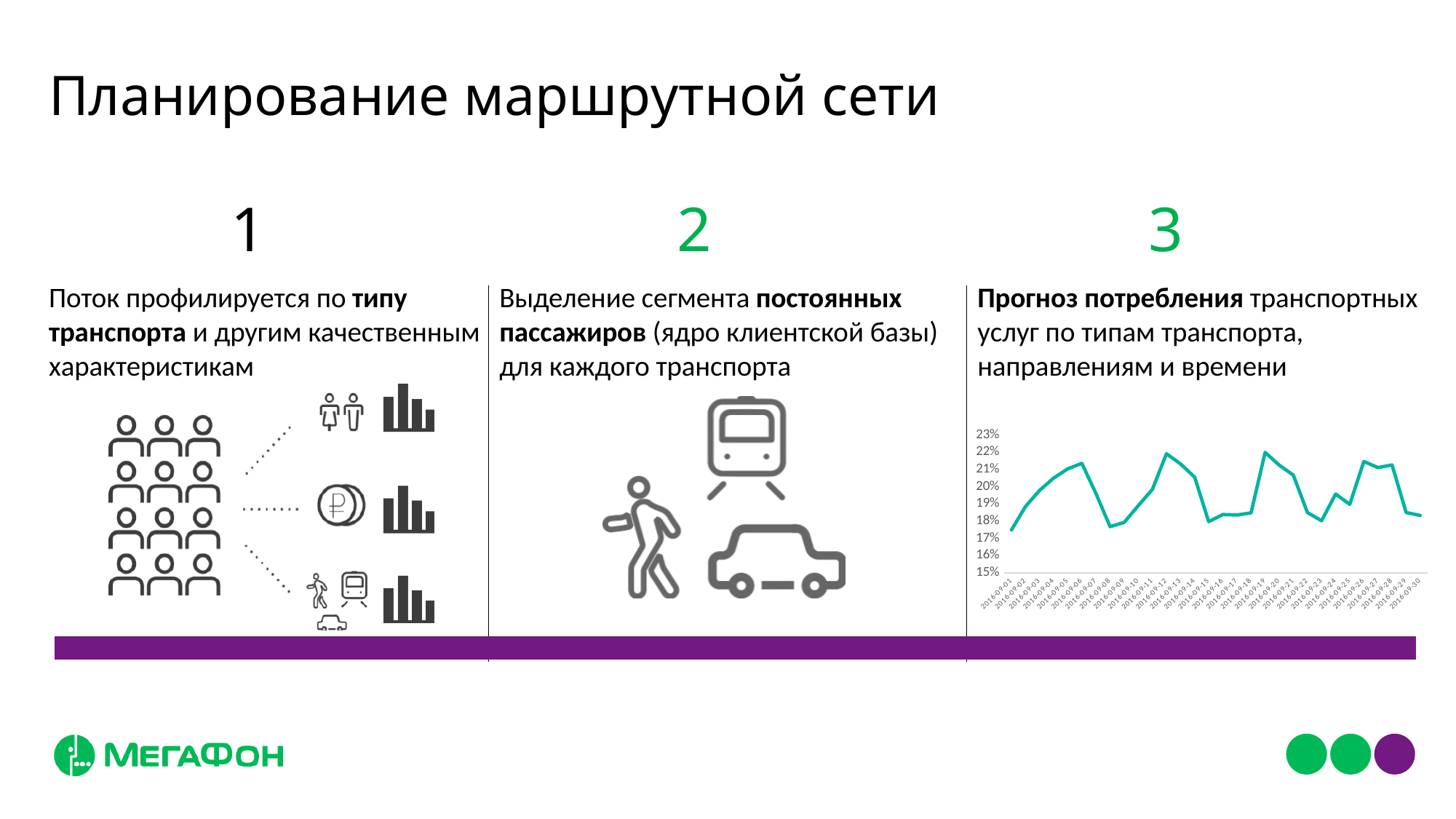
What is the highest value shown on the vertical axis of the line chart in section 3? 23% In the line chart in section 3, do the values rise or fall from 2016-09-01 to 2016-09-06? rise In the line chart in section 3, is the value for 2016-09-19 greater or less than 21%? greater In the line chart in section 3, is the value for 2016-09-08 greater or less than 18%? less In the line chart in section 3, is the value for 2016-09-12 larger or smaller than the value for 2016-09-15? larger How many data points are plotted on the line chart in section 3? 30 In the line chart in section 3, is the value for 2016-09-01 greater or less than 18%? less What is the lowest value shown on the vertical axis of the line chart in section 3? 15% What kind of chart is shown in section 3 of the slide? line chart